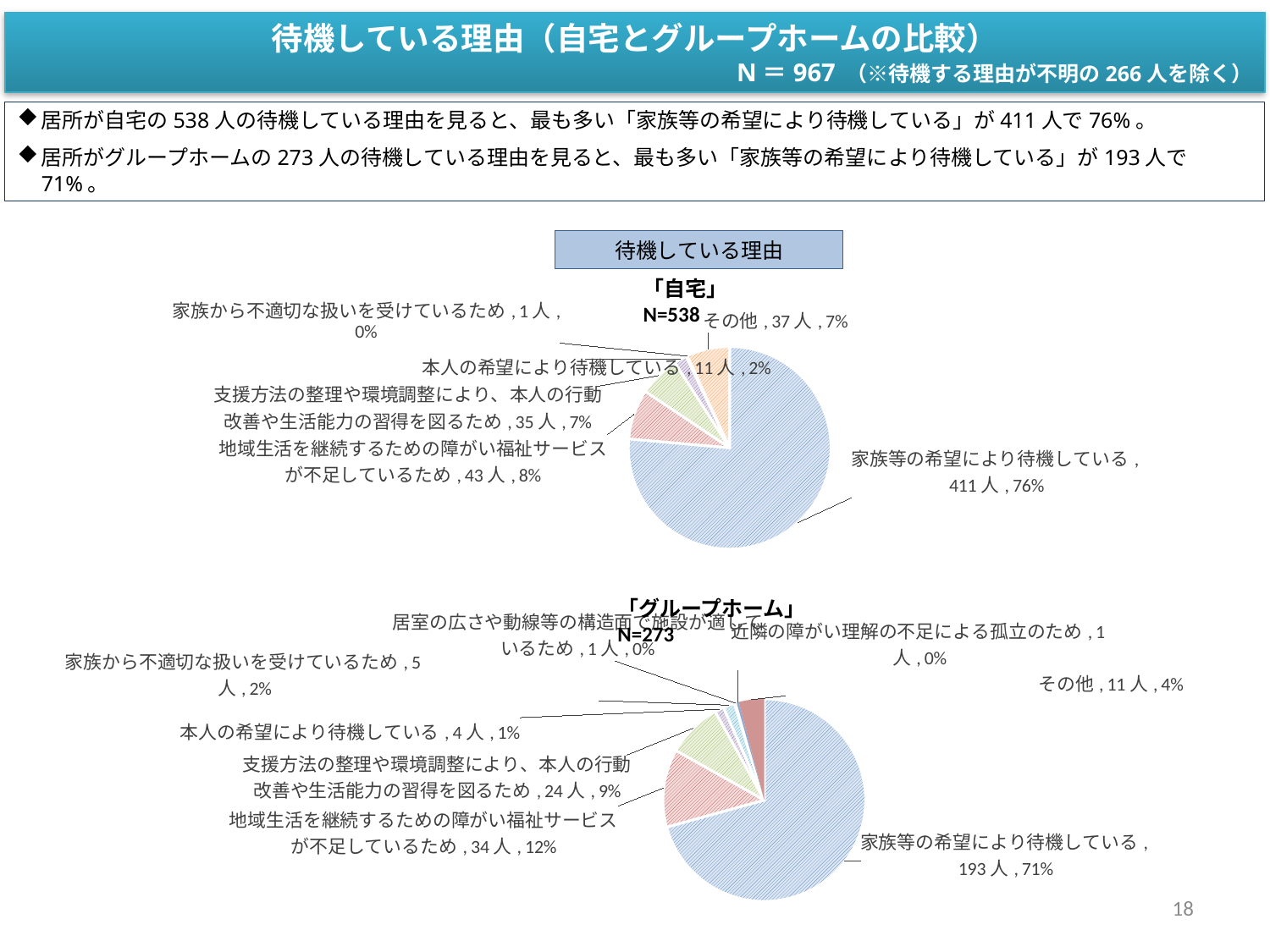
「グループホーム」の円グラフで、「家族等の希望により待機している」の割合は何%ですか？ 71% 「グループホーム」の円グラフで、「支援方法の整理や環境調整により、本人の行動改善や生活能力の習得を図るため」の人数は何人ですか？ 24人 「自宅」の円グラフで、最も人数が少ない理由はどれですか？ 家族から不適切な扱いを受けているため 「グループホーム」の円グラフには、いくつの区分（スライス）がありますか？ 8 「グループホーム」の円グラフのNはいくつですか？ N=273 「グループホーム」の円グラフで、「地域生活を継続するための障がい福祉サービスが不足しているため」と「その他」の人数の差は何人ですか？ 23人 「自宅」の円グラフで、「地域生活を継続するための障がい福祉サービスが不足しているため」の割合は何%ですか？ 8% 「自宅」の円グラフで、「家族等の希望により待機している」の人数は何人ですか？ 411人 「自宅」の円グラフで、「その他」と「本人の希望により待機している」では、どちらの人数が多いですか？ その他 「自宅」の円グラフには、いくつの区分（スライス）がありますか？ 6 このスライドの「自宅」のグラフはどの種類のグラフですか？ 円グラフ 「自宅」の円グラフで、最も人数が多い理由はどれですか？ 家族等の希望により待機している